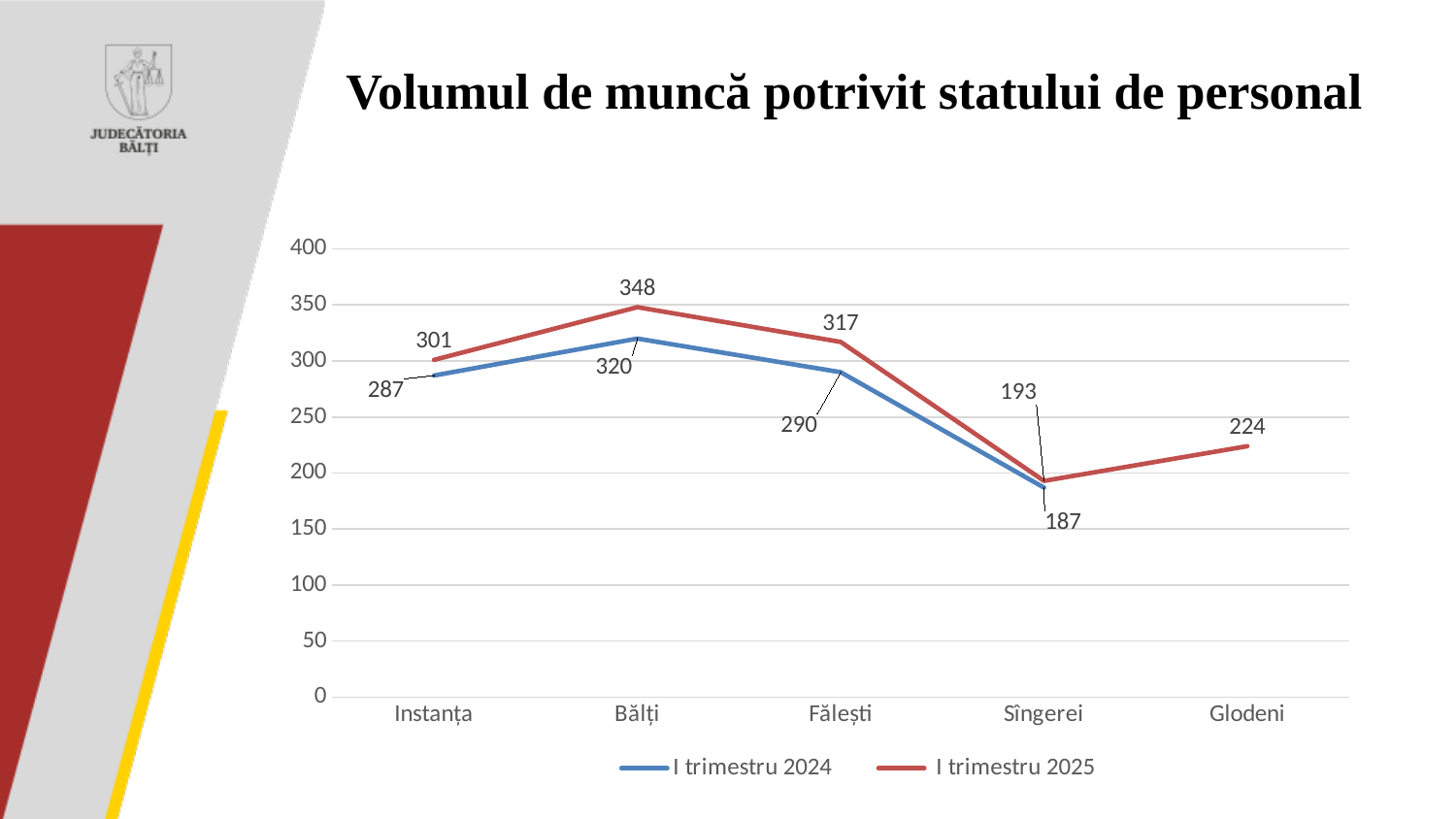
Which category has the highest value in the I trimestru 2025 series? Bălți Which is larger for Bălți: the I trimestru 2024 value or the I trimestru 2025 value? I trimestru 2025 What is the value for Bălți in the I trimestru 2025 series? 348 How many series does the legend list? 2 What is the value for Sîngerei in the I trimestru 2024 series? 187 What is the value for Glodeni in the I trimestru 2025 series? 224 What is the title of the chart? Volumul de muncă potrivit statului de personal Which category has the lowest value in the I trimestru 2024 series? Sîngerei How many categories are shown on the x axis? 5 What is the value for Instanța in the I trimestru 2024 series? 287 What is the difference between the I trimestru 2025 and I trimestru 2024 values for Fălești? 27 What kind of chart is shown on the slide? line chart